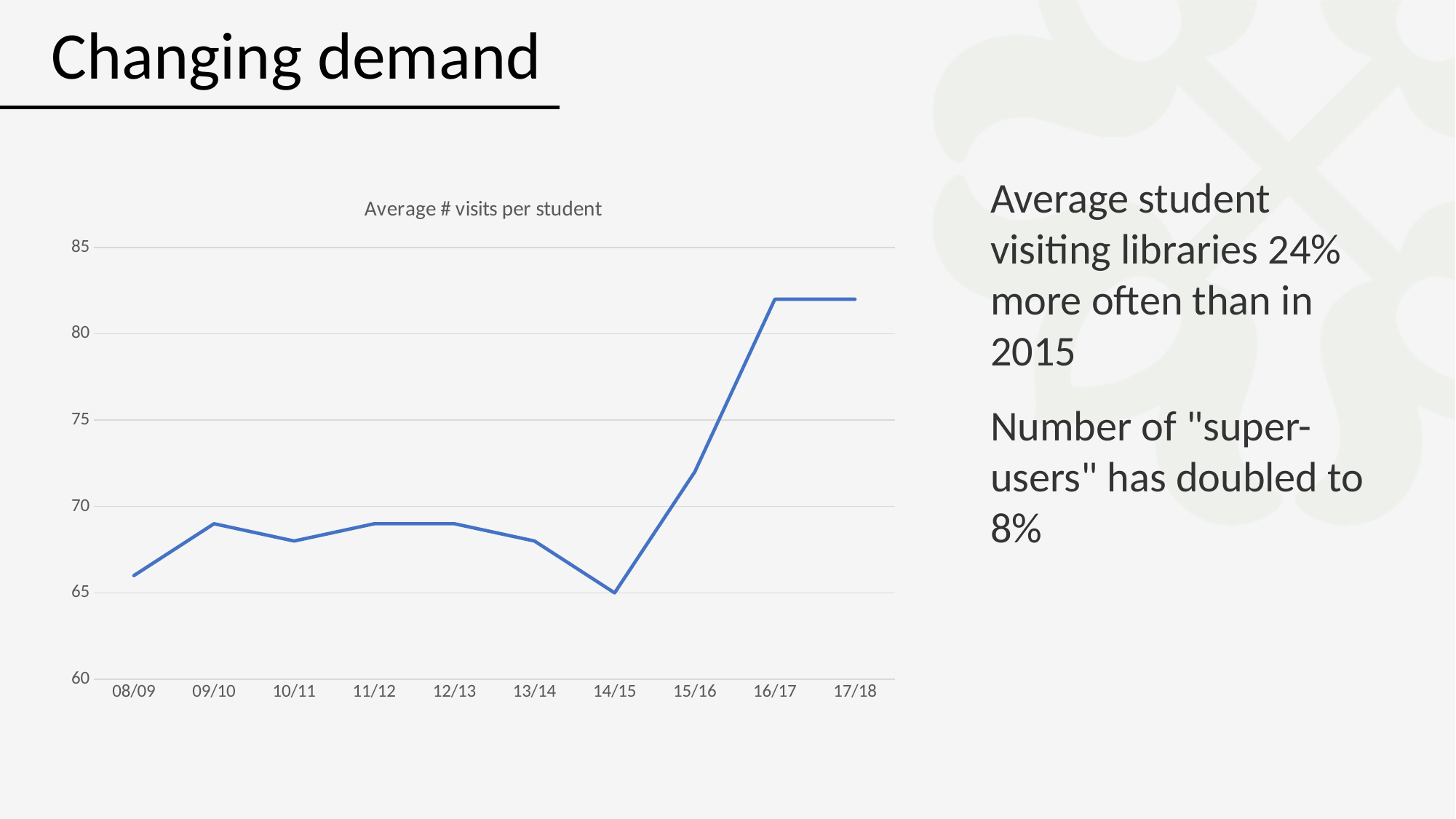
Which year has the lowest average number of visits per student? 14/15 How many academic years are plotted along the x axis? 10 Is the value for 15/16 greater or less than 70? greater What is the average number of visits per student in 14/15? 65 Is the value for 16/17 greater or less than 80? greater Is the value for 08/09 greater or less than 65? greater Which is larger, the value for 17/18 or the value for 13/14? 17/18 What is the title of the chart? Average # visits per student Which is larger, the value for 14/15 or the value for 15/16? 15/16 What kind of chart is shown on the slide? line chart Between 14/15 and 16/17, does the average number of visits per student rise or fall? rise